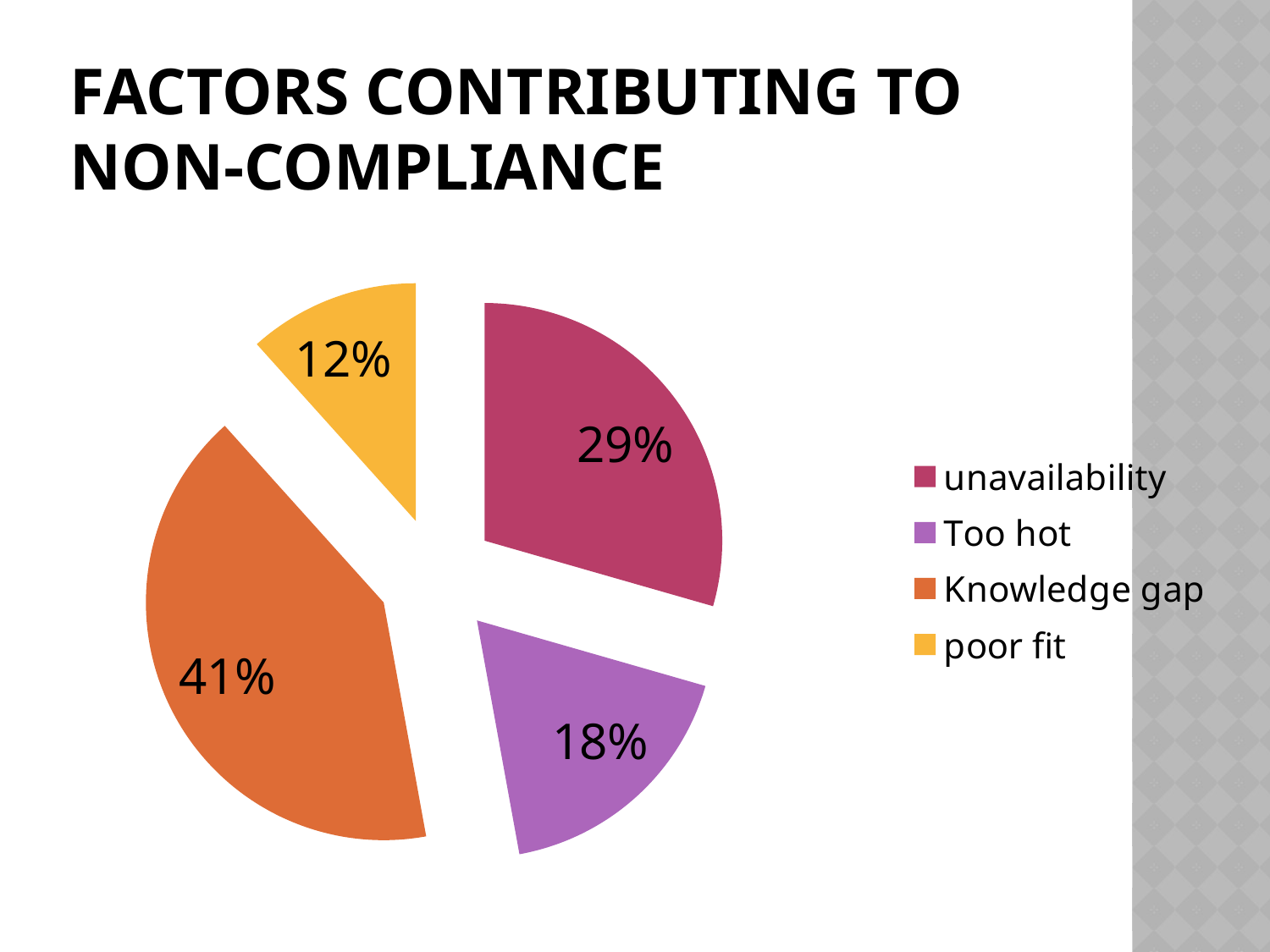
What is the value shown for Too hot? 18% How many entries does the legend list? 4 What colour is the slice for Too hot? purple What is the value shown for poor fit? 12% Which is larger, the share for Too hot or the share for poor fit? Too hot What is the difference in percentage points between Knowledge gap and unavailability? 12 How many slices does the pie chart have? 4 What share of the pie does Knowledge gap represent? 41% What kind of chart is shown on the slide? pie chart Which factor has the smallest share of the pie? poor fit What is the value shown for unavailability? 29% Which factor has the largest share of the pie? Knowledge gap